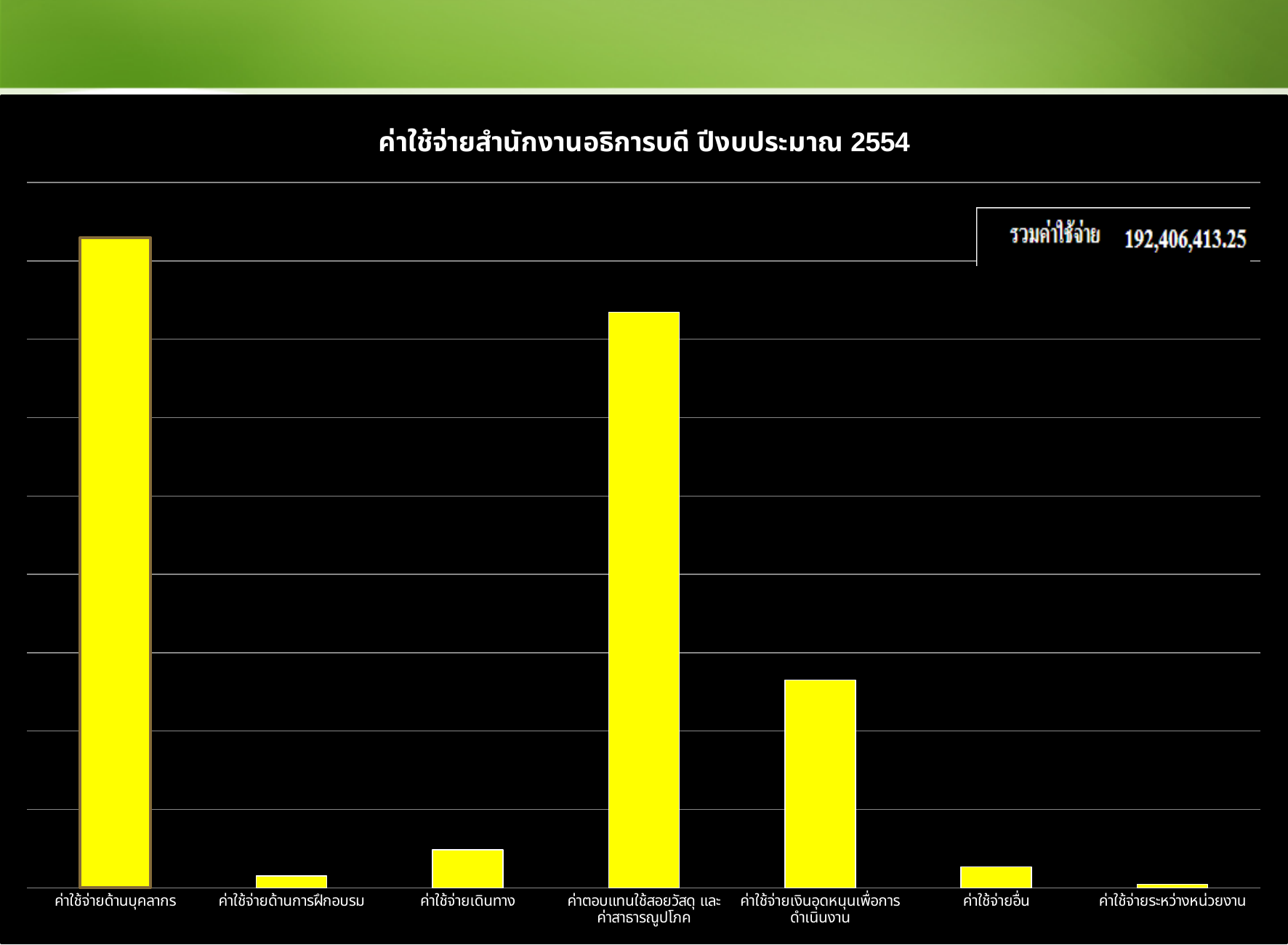
What kind of chart is shown on the slide? Bar chart Which category has the highest bar? ค่าใช้จ่ายด้านบุคลากร Which is larger, the bar for ค่าใช้จ่ายเงินอุดหนุนเพื่อการดำเนินงาน or the bar for ค่าใช้จ่ายอื่น? ค่าใช้จ่ายเงินอุดหนุนเพื่อการดำเนินงาน What is the title of the chart? ค่าใช้จ่ายสำนักงานอธิการบดี ปีงบประมาณ 2554 What total expense value (รวมค่าใช้จ่าย) is shown in the box on the chart? 192,406,413.25 Which is larger, the bar for ค่าใช้จ่ายด้านการฝึกอบรม or the bar for ค่าใช้จ่ายระหว่างหน่วยงาน? ค่าใช้จ่ายด้านการฝึกอบรม Which is larger, the bar for ค่าใช้จ่ายเดินทาง or the bar for ค่าใช้จ่ายด้านการฝึกอบรม? ค่าใช้จ่ายเดินทาง Which category has the lowest bar? ค่าใช้จ่ายระหว่างหน่วยงาน Which category has the second-highest bar? ค่าตอบแทนใช้สอยวัสดุ และค่าสาธารณูปโภค How many expense categories are plotted on the x axis? 7